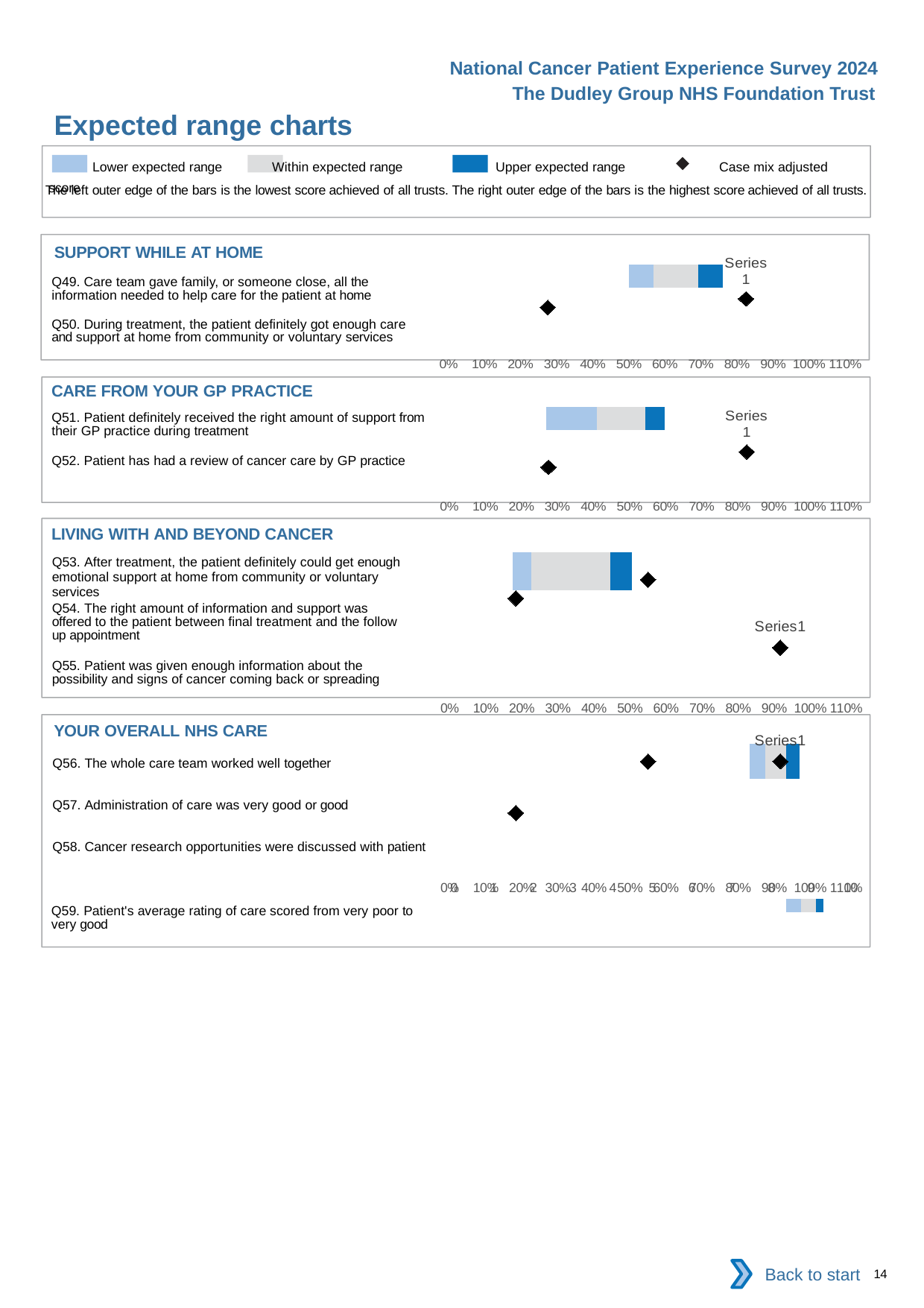
How many questions are listed in the LIVING WITH AND BEYOND CANCER section? 3 What is the highest tick label shown on the x axis of the charts? 110% In the LIVING WITH AND BEYOND CANCER chart, is the right edge of the expected range bar greater or less than 40%? greater In the CARE FROM YOUR GP PRACTICE chart, is the left edge of the expected range bar greater or less than 40%? less How many questions are listed in the CARE FROM YOUR GP PRACTICE section? 2 In the SUPPORT WHILE AT HOME chart, is the left edge of the expected range bar greater or less than 40%? greater How many questions are listed in the YOUR OVERALL NHS CARE section? 4 How many entries does the legend at the top of the slide list? 4 What kind of chart is used in the SUPPORT WHILE AT HOME section? bar chart Which legend entry is represented by a diamond marker? Case mix adjusted score